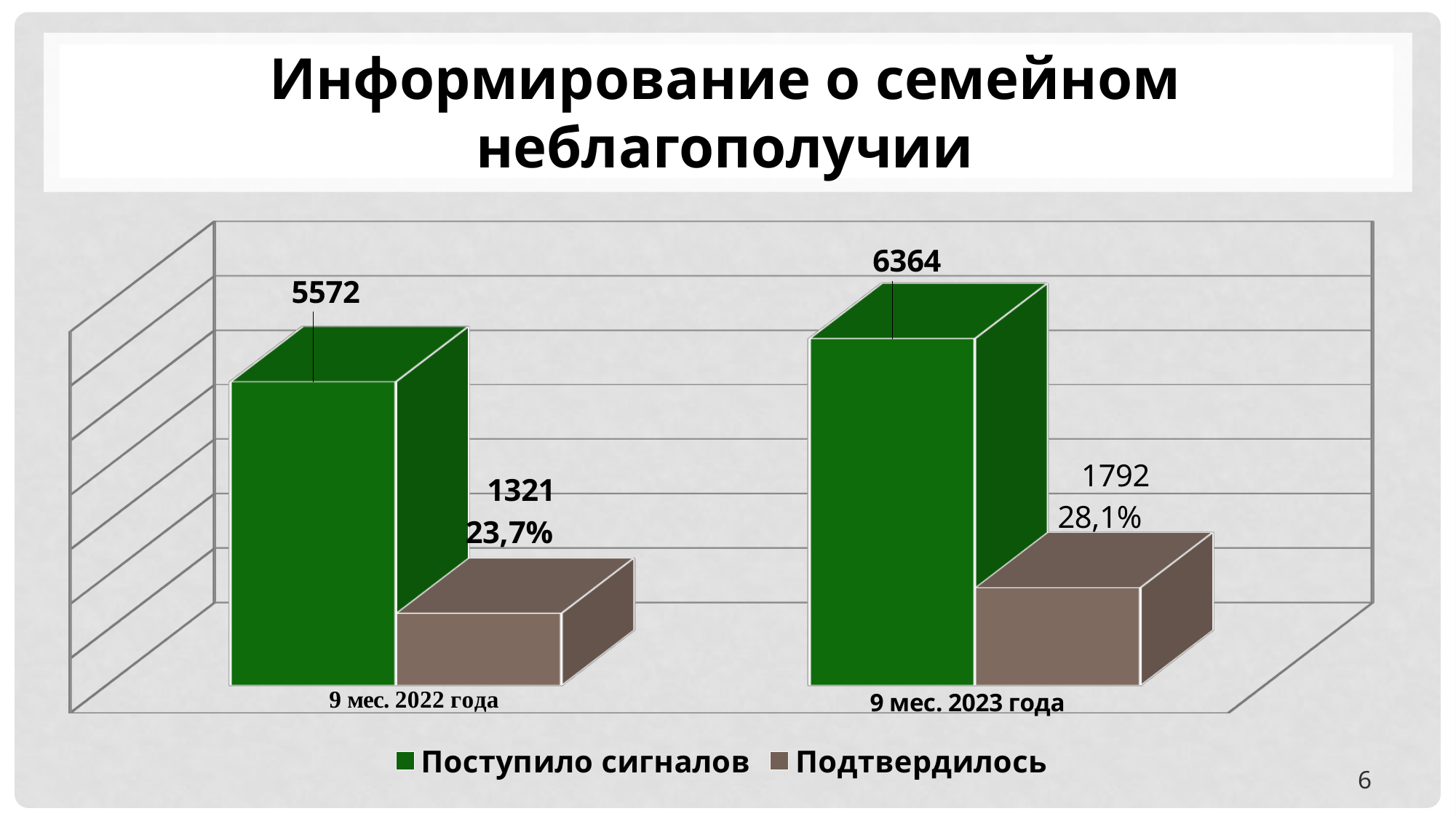
What percentage is shown next to the "Подтвердилось" bar for "9 мес. 2022 года"? 23,7% What is the value of "Подтвердилось" for "9 мес. 2023 года"? 1792 What is the difference between "Поступило сигналов" for "9 мес. 2023 года" and "9 мес. 2022 года"? 792 What is the difference between "Подтвердилось" for "9 мес. 2023 года" and "9 мес. 2022 года"? 471 What is the value of "Поступило сигналов" for "9 мес. 2023 года"? 6364 Which is larger: "Подтвердилось" for "9 мес. 2022 года" or "Подтвердилось" for "9 мес. 2023 года"? 9 мес. 2023 года Which category has the higher value for "Поступило сигналов"? 9 мес. 2023 года What is the value of "Поступило сигналов" for "9 мес. 2022 года"? 5572 What type of chart is shown on the slide? Bar chart How many series does the legend list? 2 What is the value of "Подтвердилось" for "9 мес. 2022 года"? 1321 What percentage is shown next to the "Подтвердилось" bar for "9 мес. 2023 года"? 28,1%